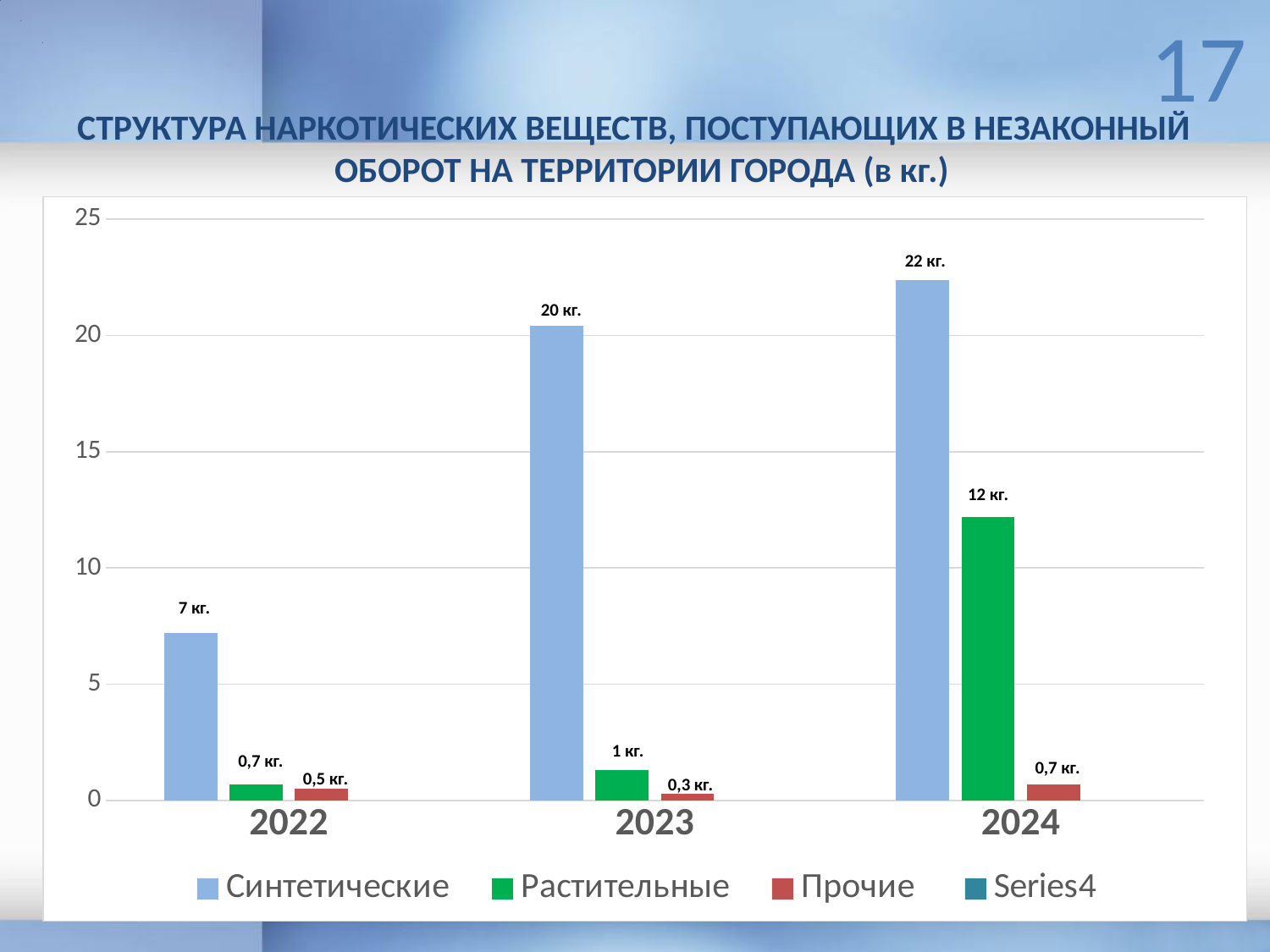
What is the value for Растительные in 2023? 1 кг. What is the value for Прочие in 2022? 0,5 кг. Which is larger in 2024: the value for Растительные or the value for Прочие? Растительные What is the value for Синтетические in 2024? 22 кг. How many years are shown on the x axis? 3 How many series does the legend list? 4 Do the values for Синтетические rise or fall from 2022 to 2024? rise In which year is the value for Прочие the lowest? 2023 In which year is the value for Синтетические the highest? 2024 What kind of chart is shown on the slide? bar chart What is the difference between the Синтетические values for 2023 and 2022? 13 кг. Is the value for Растительные in 2024 greater or less than 10? greater